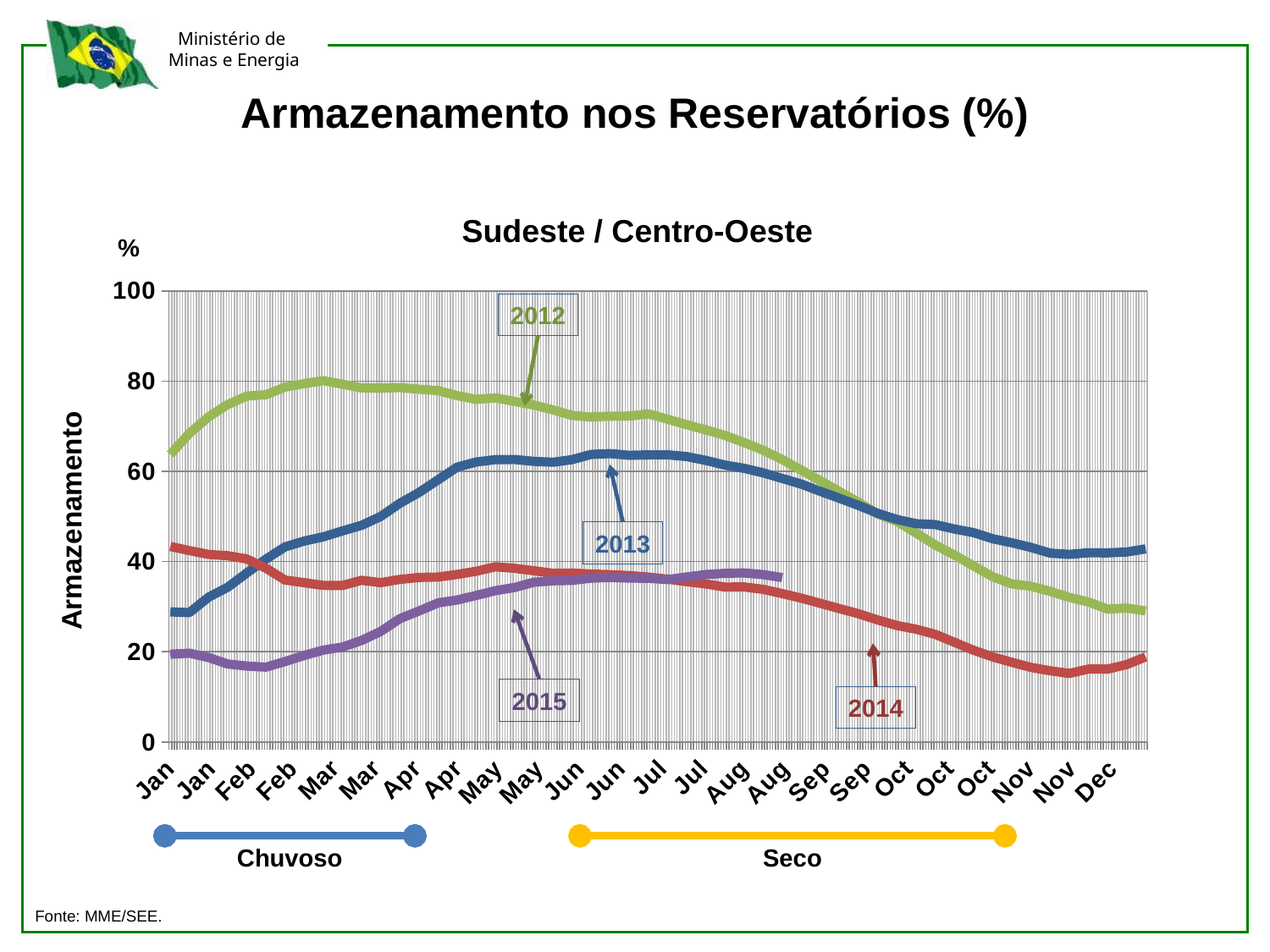
Is the value for 2014 in November greater or less than 20? less Which year's line is lowest at the start of January? 2015 How many years (series) are plotted on the chart? 4 Is the value for 2012 in early March greater or less than 60? greater What kind of chart is shown on the slide? line chart Is the value for 2015 in February greater or less than 20? less Which year's line is highest at the start of January? 2012 In December, which line is higher, 2013 or 2014? 2013 Does the 2012 line rise or fall from March to December? fall Does the 2013 line rise or fall from January to June? rise What is the title of the chart? Sudeste / Centro-Oeste